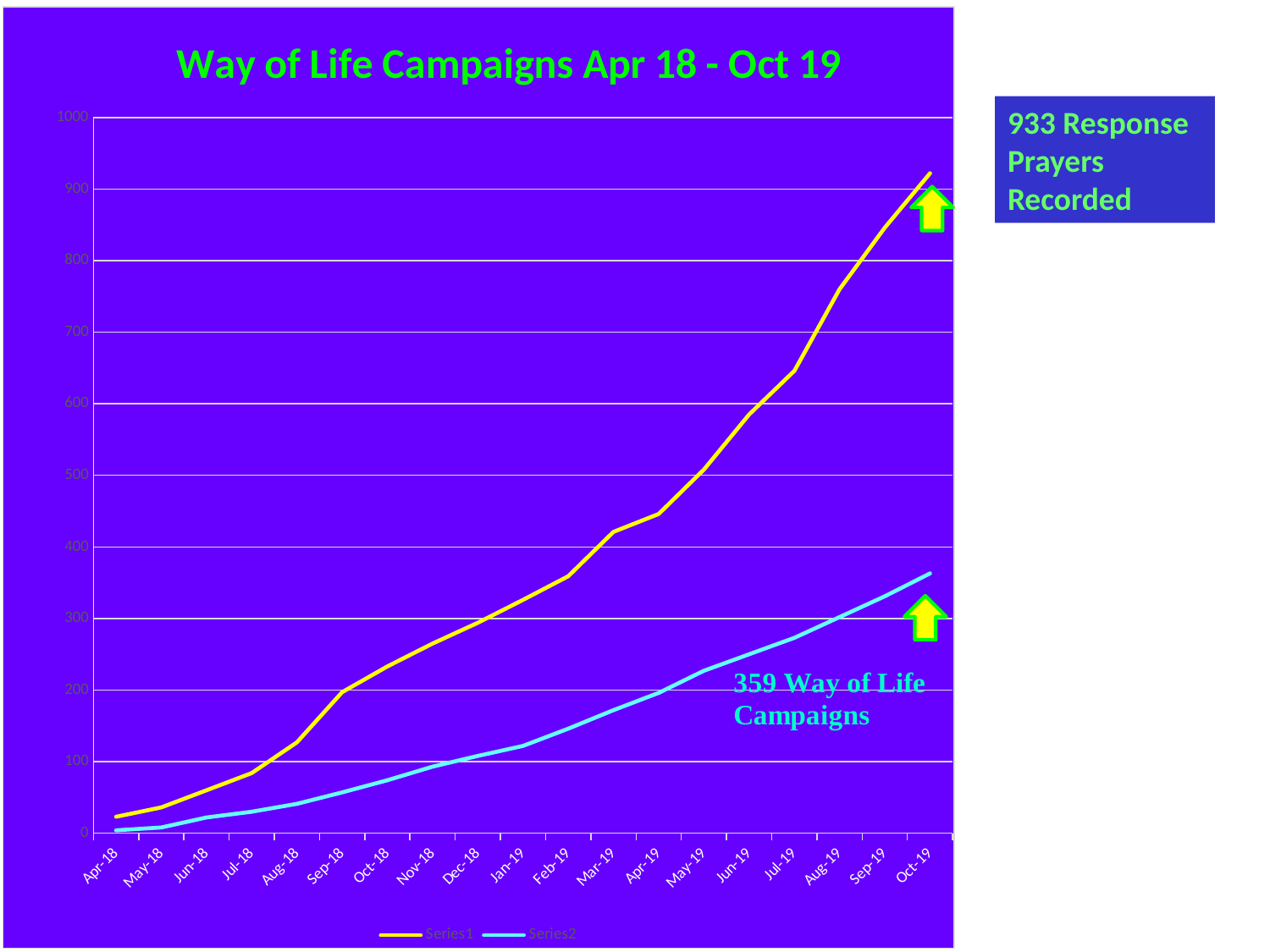
At Oct-19, which series has the larger value, Series1 or Series2? Series1 How many series does the legend list? 2 Does the Series2 line rise or fall from Apr-18 to Oct-19? rise Is the Series2 value for Oct-19 greater or less than 300? greater Is the Series1 value for Apr-19 greater or less than 500? less Is the Series1 value for Oct-19 greater or less than 800? greater Does the Series1 line rise or fall from Apr-18 to Oct-19? rise In which month does Series1 reach its highest value? Oct-19 What is the title of the chart? Way of Life Campaigns Apr 18 - Oct 19 What kind of chart is shown on the slide? line chart How many months are plotted along the x axis? 19